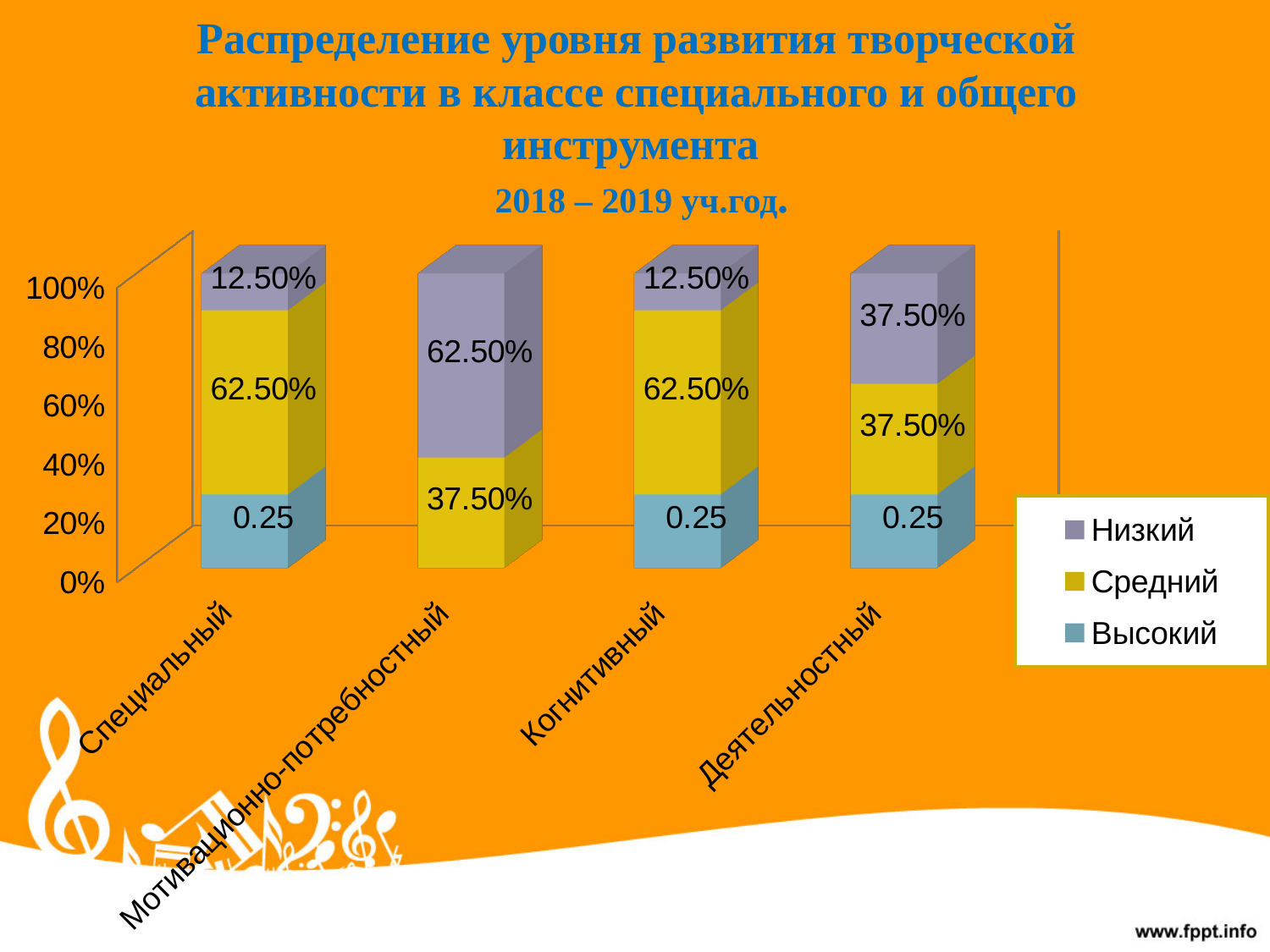
How many categories are shown on the x axis? 4 What is the value of the Средний segment for Мотивационно-потребностный? 37.50% Which category has the highest Низкий value? Мотивационно-потребностный How many series does the legend list? 3 What is the value of the Средний segment for Специальный? 62.50% Which is larger, the Средний value for Специальный or for Деятельностный? Специальный What is the value of the Низкий segment for Деятельностный? 37.50% Which is larger, the Низкий value for Мотивационно-потребностный or for Когнитивный? Мотивационно-потребностный Which colour represents the Средний series in the legend? Yellow What kind of chart is shown on the slide? Stacked bar chart What is the value of the Высокий segment for Когнитивный? 0.25 What is the value of the Низкий segment for Мотивационно-потребностный? 62.50%